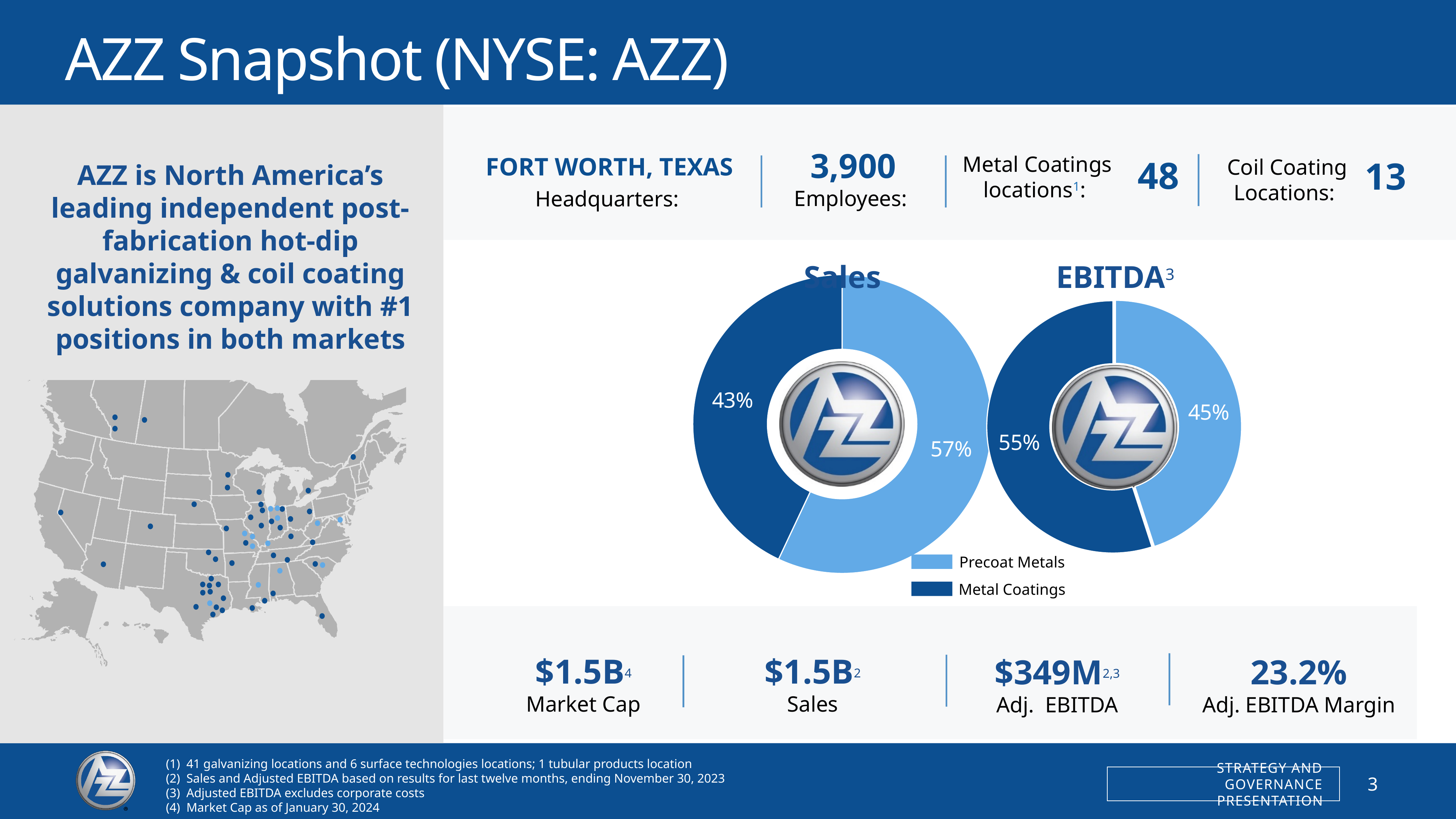
What type of chart is used for the Sales and EBITDA breakdowns? Doughnut chart In the EBITDA chart, what share is attributed to Precoat Metals? 45% In the Sales chart, what share of sales comes from Metal Coatings? 43% In the EBITDA chart, what share is attributed to Metal Coatings? 55% In the EBITDA chart, which segment has the smaller share? Precoat Metals Which segment is shown in dark blue in the legend? Metal Coatings How many segments does the legend list for the Sales and EBITDA charts? 2 In the Sales chart, what share of sales comes from Precoat Metals? 57% In the EBITDA chart, what is the difference in percentage points between the Metal Coatings and Precoat Metals shares? 10 Is the Metal Coatings share larger in the Sales chart or in the EBITDA chart? EBITDA chart In the Sales chart, what is the difference in percentage points between the Precoat Metals and Metal Coatings shares? 14 In the Sales chart, which segment has the larger share? Precoat Metals